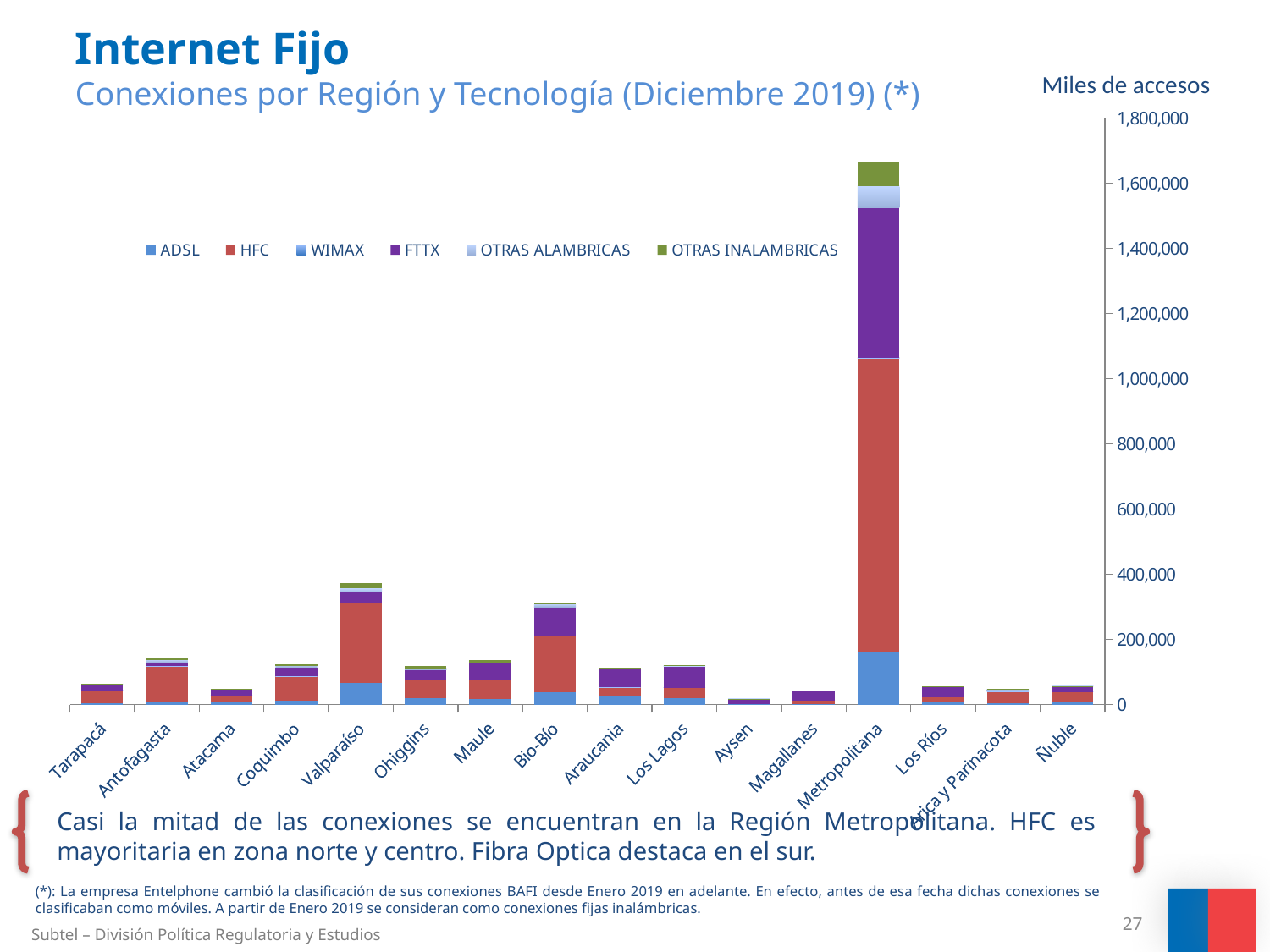
How many regions are shown along the x axis of the chart? 16 Which region has the lowest total number of connections? Aysen Which region has the highest total number of connections? Metropolitana Which region has a larger total, Valparaíso or Bio-Bío? Valparaíso Is the total value for Metropolitana greater or less than 1,600,000? greater Which region has a larger total, Antofagasta or Atacama? Antofagasta Which series is shown in purple in the chart legend? FTTX Is the total value for Tarapacá greater or less than 200,000? less What unit is indicated for the chart's values? Miles de accesos What kind of chart is shown on the slide? Stacked bar chart Is the total value for Valparaíso greater or less than 200,000? greater How many series does the chart legend list? 6